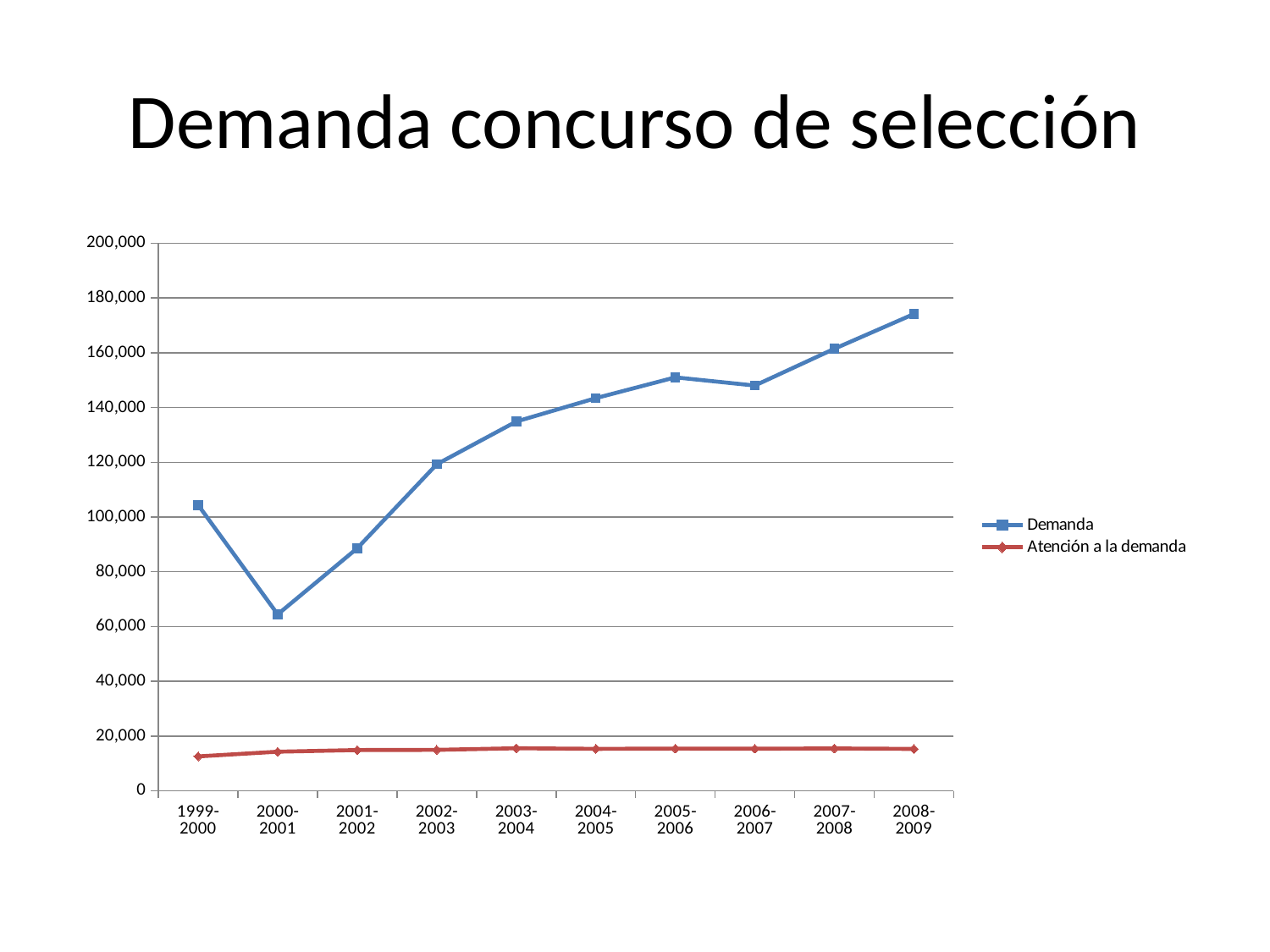
Is the Demanda value for 2000-2001 greater or less than 80,000? less Does the Demanda series rise or fall from 2000-2001 to 2005-2006? rise Is the Demanda value for 2003-2004 greater or less than 140,000? less In which period is the Demanda series lowest? 2000-2001 How many series does the legend list? 2 How many periods are shown on the x axis? 10 What is the title of the chart? Demanda concurso de selección What kind of chart is shown on the slide? Line chart Is the Atención a la demanda value for 2008-2009 greater or less than 20,000? less Which is larger for Demanda: the value for 2001-2002 or the value for 2002-2003? 2002-2003 In which period is the Demanda series highest? 2008-2009